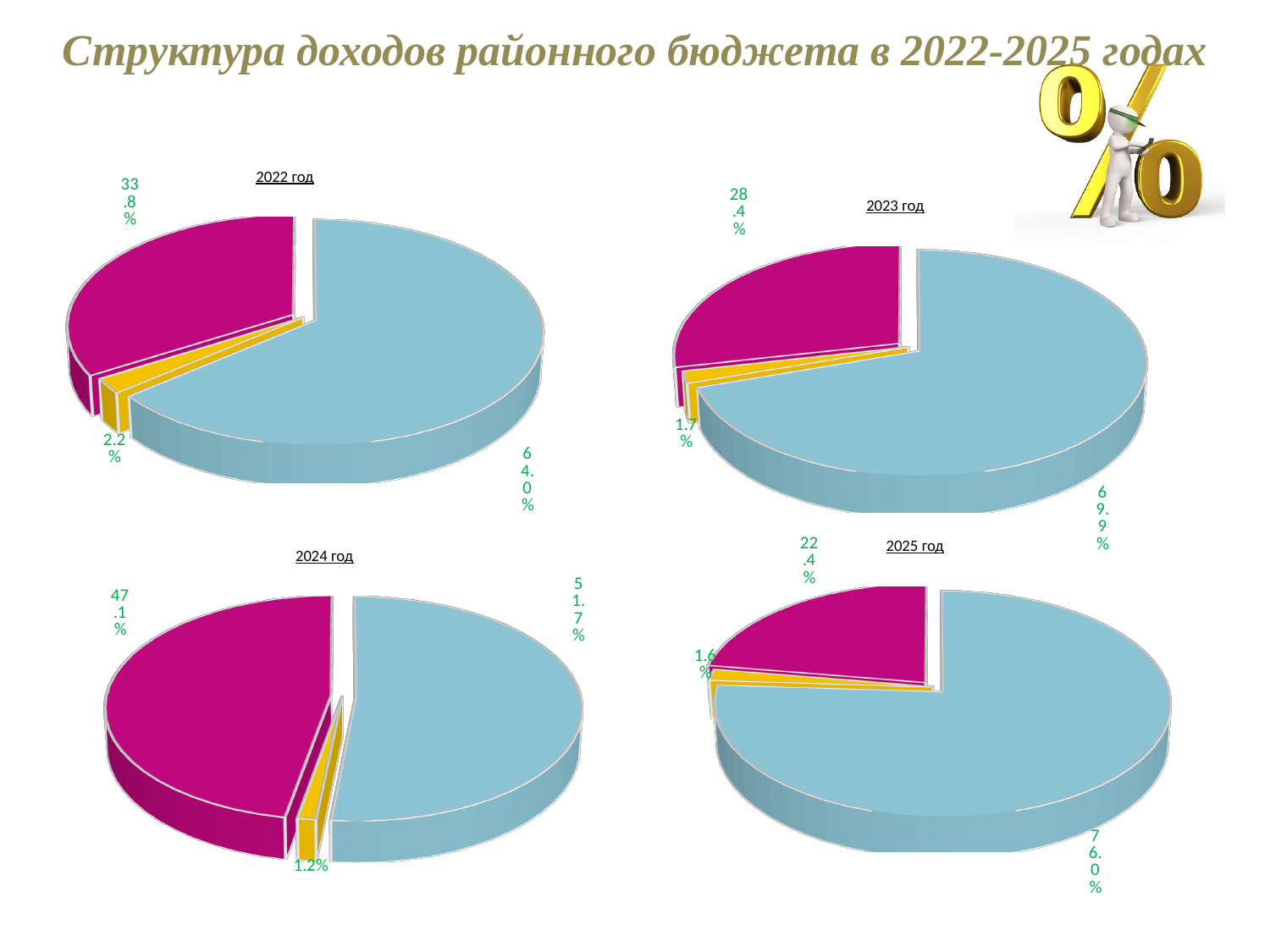
In the 2023 год chart, what is the value of the light blue slice? 69.9% In the 2024 год chart, which slice is the largest? the light blue slice (51.7%) How many pie charts are on the slide? 4 In the 2025 год chart, what is the difference between the light blue slice and the magenta slice? 53.6% In the 2025 год chart, what is the value of the light blue slice? 76.0% In the 2022 год chart, what is the value of the largest (light blue) slice? 64.0% How many slices does each pie chart on the slide have? 3 What kind of chart is used for each of the four years on the slide? pie chart In the 2023 год chart, what is the value of the smallest (yellow) slice? 1.7% In the 2024 год chart, what is the value of the magenta slice? 47.1% What is the title of the slide? Структура доходов районного бюджета в 2022-2025 годах In the 2022 год chart, what is the value of the magenta slice? 33.8%